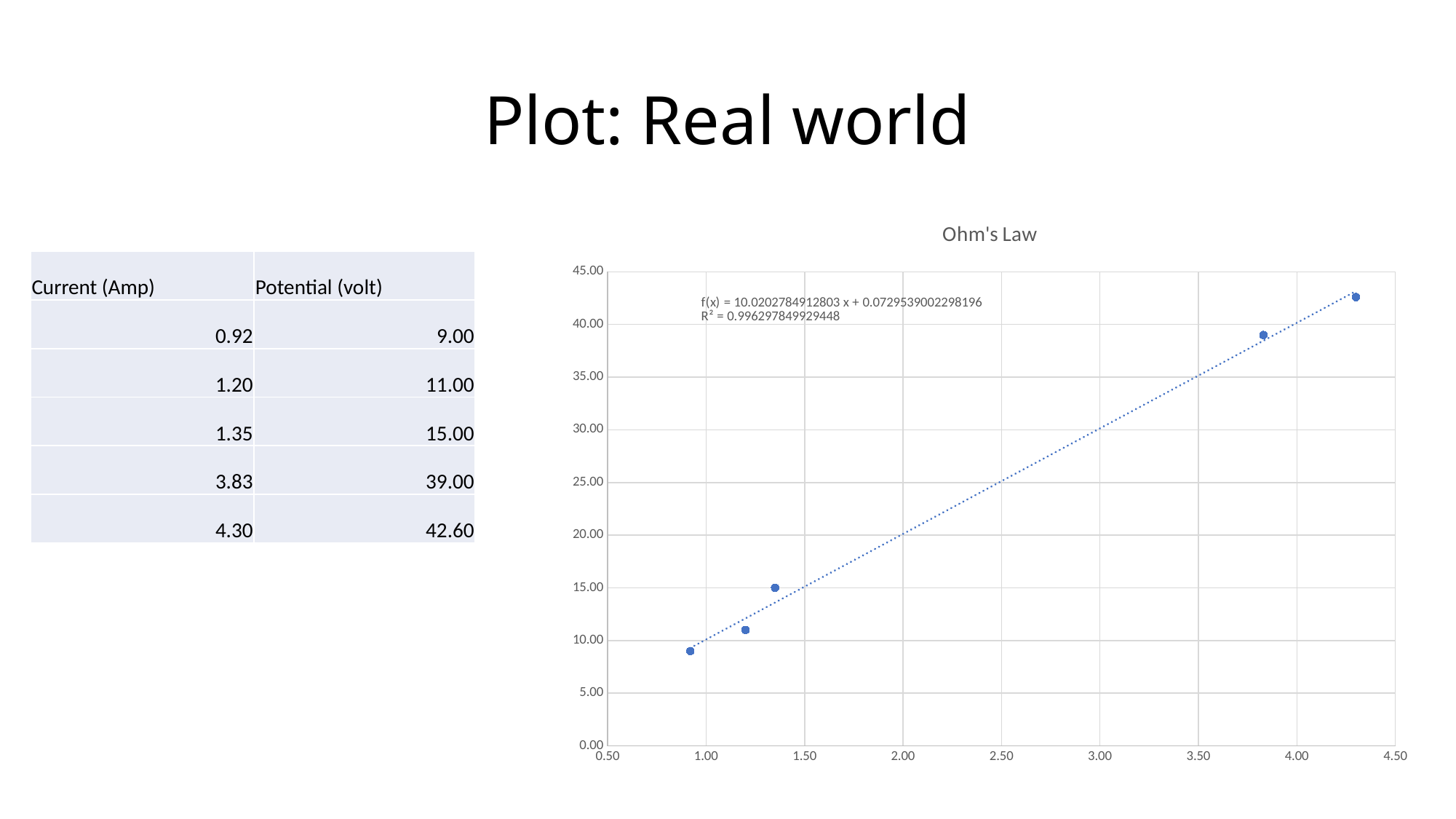
How many data points are plotted on the 'Ohm's Law' chart? 5 On the 'Ohm's Law' chart, which current value has the highest potential? 4.30 On the 'Ohm's Law' chart, is the potential at a current of 1.35 greater or less than 20.00? less What is the title of the chart on the slide? Ohm's Law On the 'Ohm's Law' chart, is the potential at a current of 3.83 greater or less than 35.00? greater On the 'Ohm's Law' chart, which current value has the lowest potential? 0.92 What R² value is shown for the trendline on the 'Ohm's Law' chart? 0.996297849929448 On the 'Ohm's Law' chart, which has the larger potential: the point at 1.20 Amp or the point at 1.35 Amp? 1.35 Amp Do the plotted values on the 'Ohm's Law' chart rise or fall as current increases along the x axis? rise What is the difference in potential between the points at 4.30 Amp and 3.83 Amp? 3.60 What is the potential (volt) at a current of 3.83 Amp? 39.00 What kind of chart is the 'Ohm's Law' chart? scatter chart